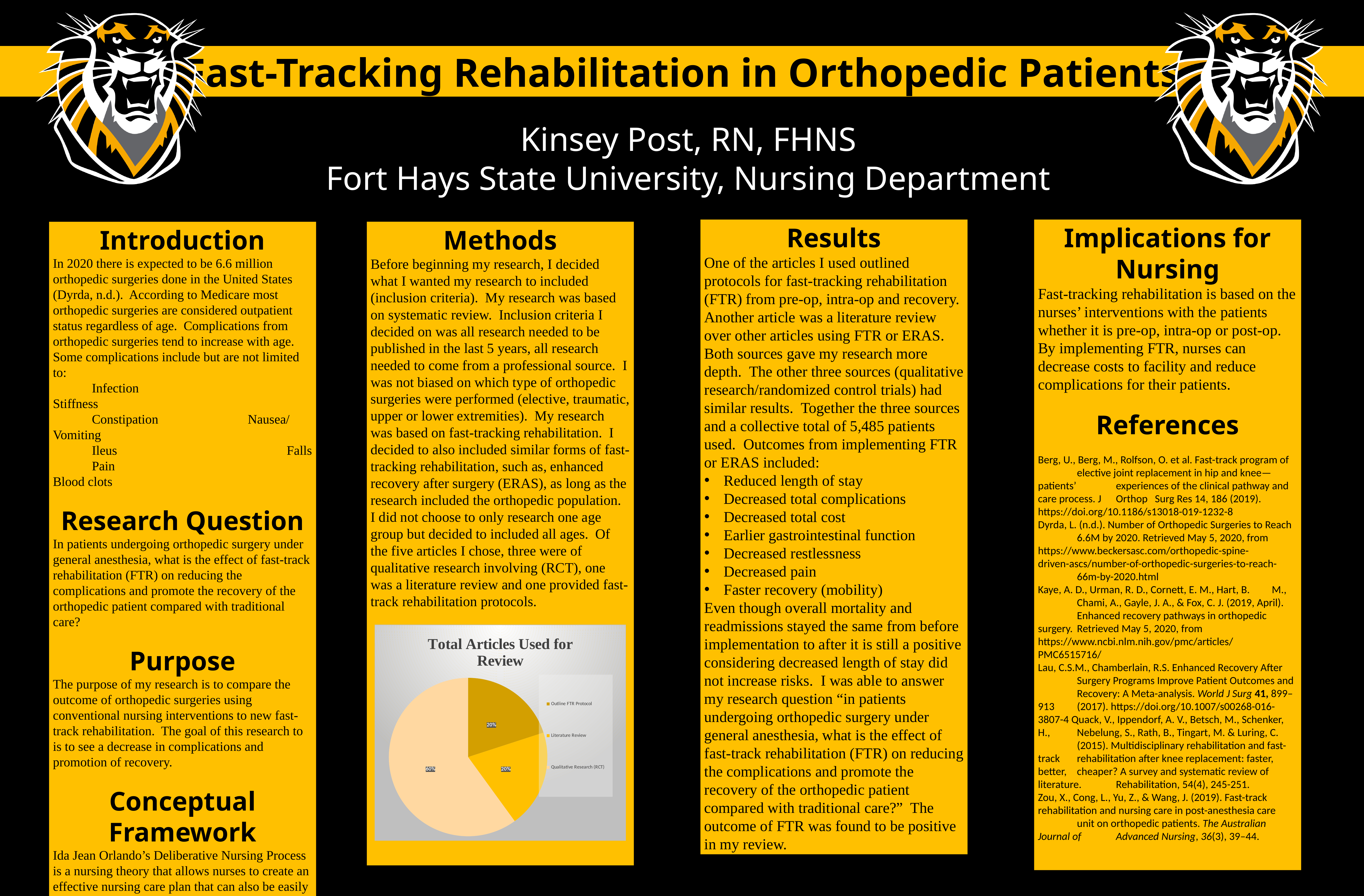
What is the title of the chart? Total Articles Used for Review Which category has the largest slice of the pie? Qualitative Research (RCT) What kind of chart is shown on the slide? pie chart How many slices does the pie chart have? 3 Which legend entry is listed first in the chart's legend? Outline FTR Protocol What share of the pie is Literature Review? 20% What is the difference in percentage points between the Qualitative Research (RCT) slice and the Outline FTR Protocol slice? 40% What share of the pie is Qualitative Research (RCT)? 60% What share of the pie is Outline FTR Protocol? 20% Which is larger, the slice for Qualitative Research (RCT) or the slice for Literature Review? Qualitative Research (RCT) How many entries does the chart's legend list? 3 Is the share for Qualitative Research (RCT) greater or less than 50%? greater